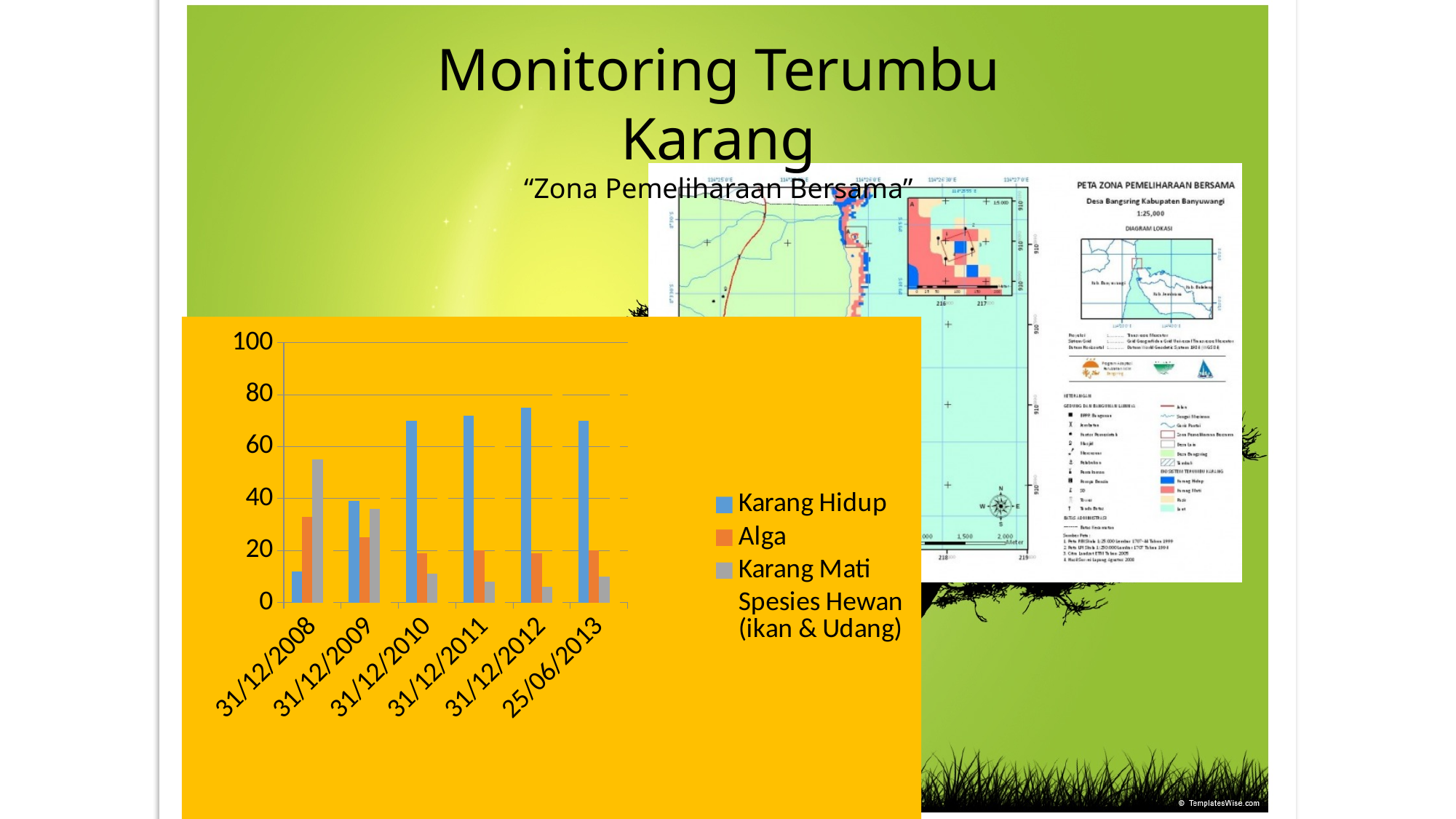
Which series in the legend is shown in blue? Karang Hidup Is the value for Karang Hidup on 31/12/2008 greater or less than 20? less Is the value for Karang Hidup on 31/12/2012 greater or less than 60? greater Is the value for Karang Mati on 31/12/2012 greater or less than 20? less How many dates are shown on the x axis of the bar chart? 6 On which date is the Karang Hidup bar the lowest? 31/12/2008 How many series does the legend of the bar chart list? 4 Does the Karang Mati series generally rise or fall from 31/12/2008 to 25/06/2013? fall On which date is the Karang Mati bar the highest? 31/12/2008 What kind of chart is shown on the slide? bar chart On 31/12/2008, which is larger: Karang Hidup or Karang Mati? Karang Mati